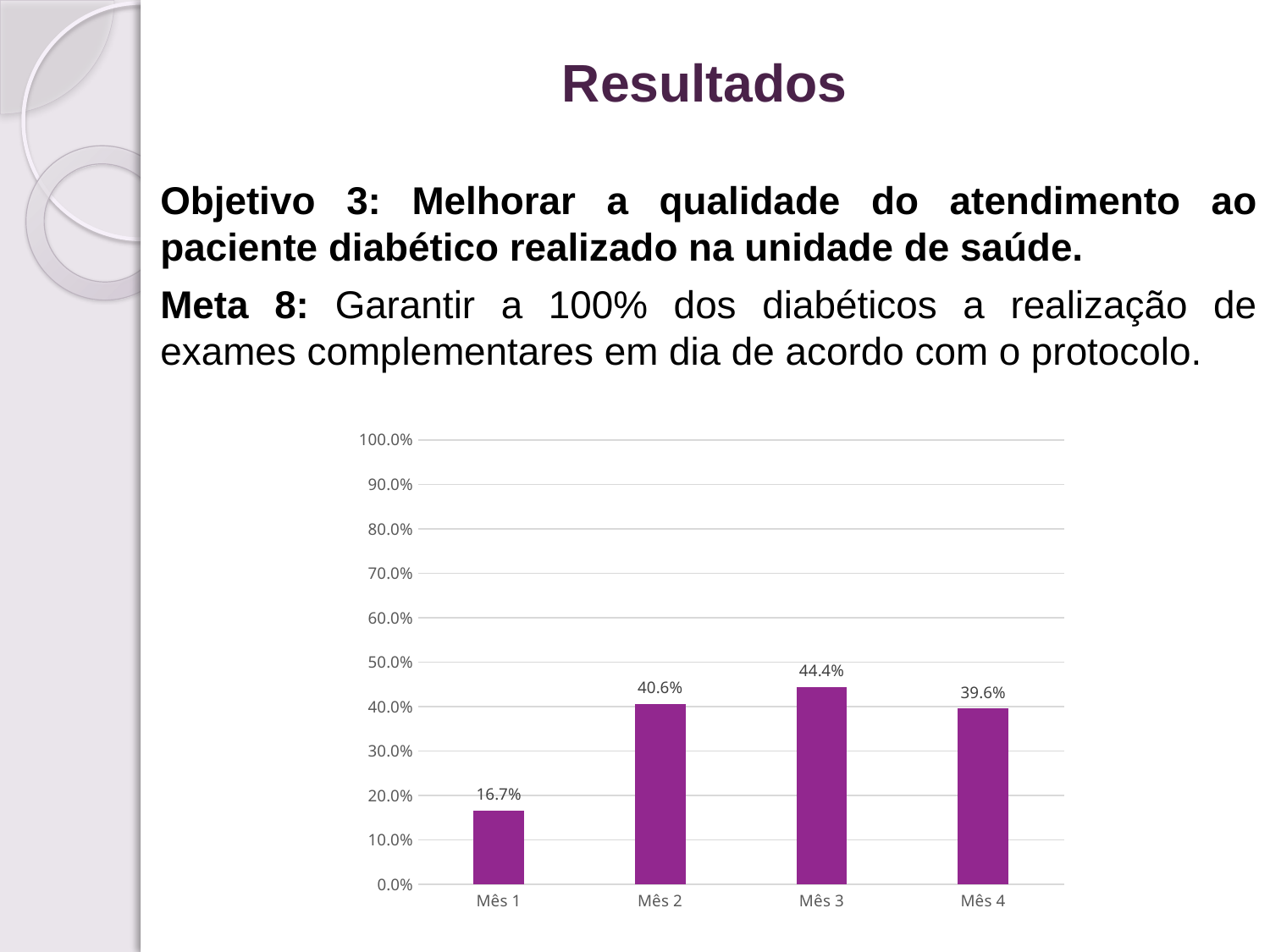
What is the value for Mês 4? 39.6% What kind of chart is shown on the slide? bar chart What is the difference between the values for Mês 2 and Mês 4? 1.0% Which month has the lowest value? Mês 1 What is the highest value shown on the y axis? 100.0% Which month has the highest value? Mês 3 Which is larger, the value for Mês 2 or the value for Mês 1? Mês 2 What is the difference between the values for Mês 3 and Mês 1? 27.7% What is the value for Mês 1? 16.7% How many months are shown on the x axis? 4 What is the value for Mês 3? 44.4% Is the value for Mês 3 greater or less than 50.0%? less